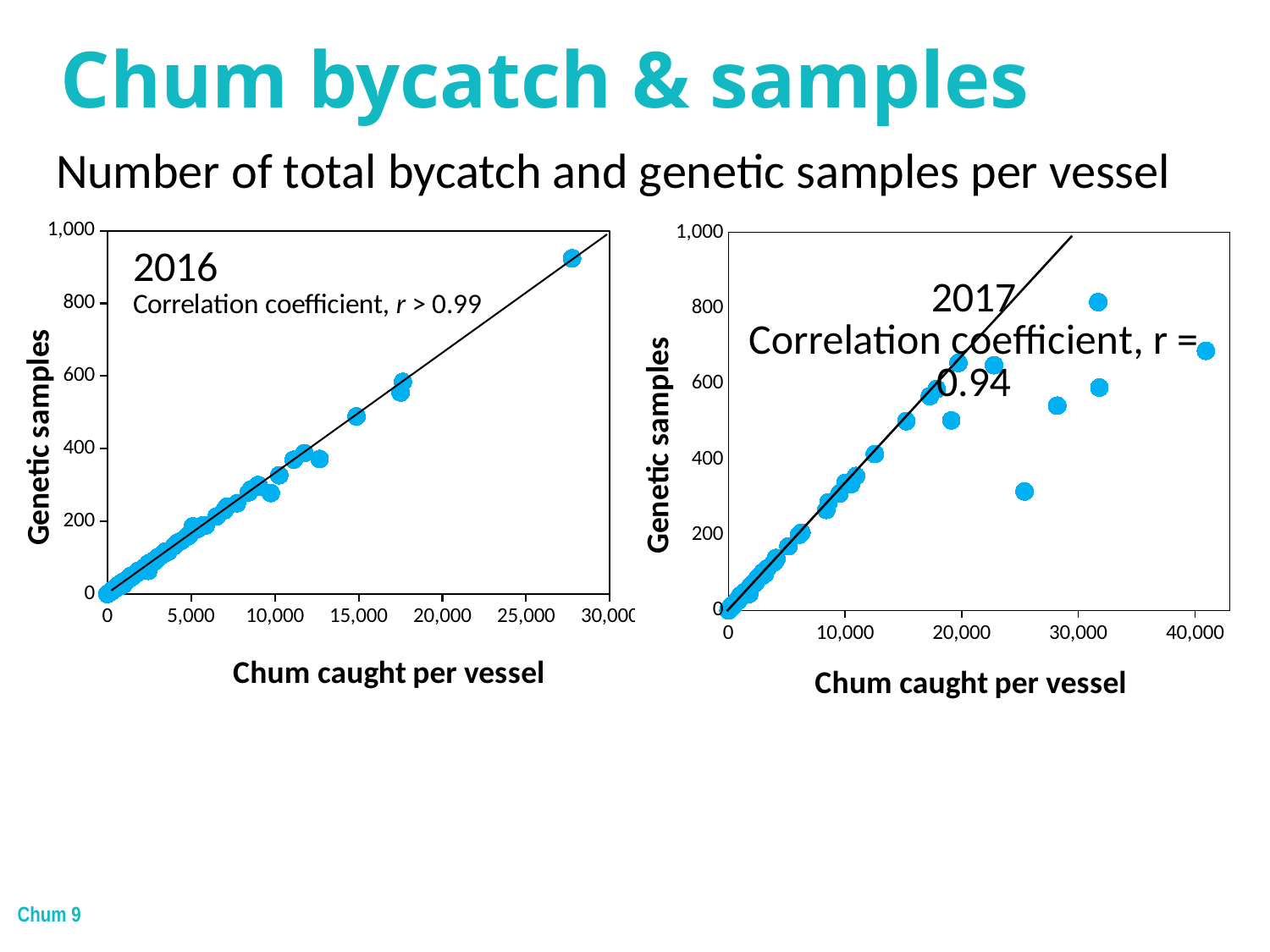
Which chart shows the higher correlation coefficient, 2016 or 2017? 2016 What kind of chart is the 2016 chart on the left? Scatter chart In the 2017 chart, is the genetic samples value for the vessel with the most chum caught (around 40,000) greater or less than 600? greater In the 2016 chart, what is the highest value shown on the y axis? 1,000 In the 2017 chart, do genetic samples generally rise or fall as chum caught per vessel increases? Rise In the 2016 chart, do genetic samples rise or fall as chum caught per vessel increases? Rise In the 2017 chart, is the genetic samples value for the vessel that caught about 25,000 chum greater or less than 400? less In the 2017 chart, what is the label of the y axis? Genetic samples What kind of chart is the 2017 chart on the right? Scatter chart In the 2016 chart, is the genetic samples value for the vessel with the most chum caught greater or less than 800? greater In the 2016 chart, what is the label of the x axis? Chum caught per vessel